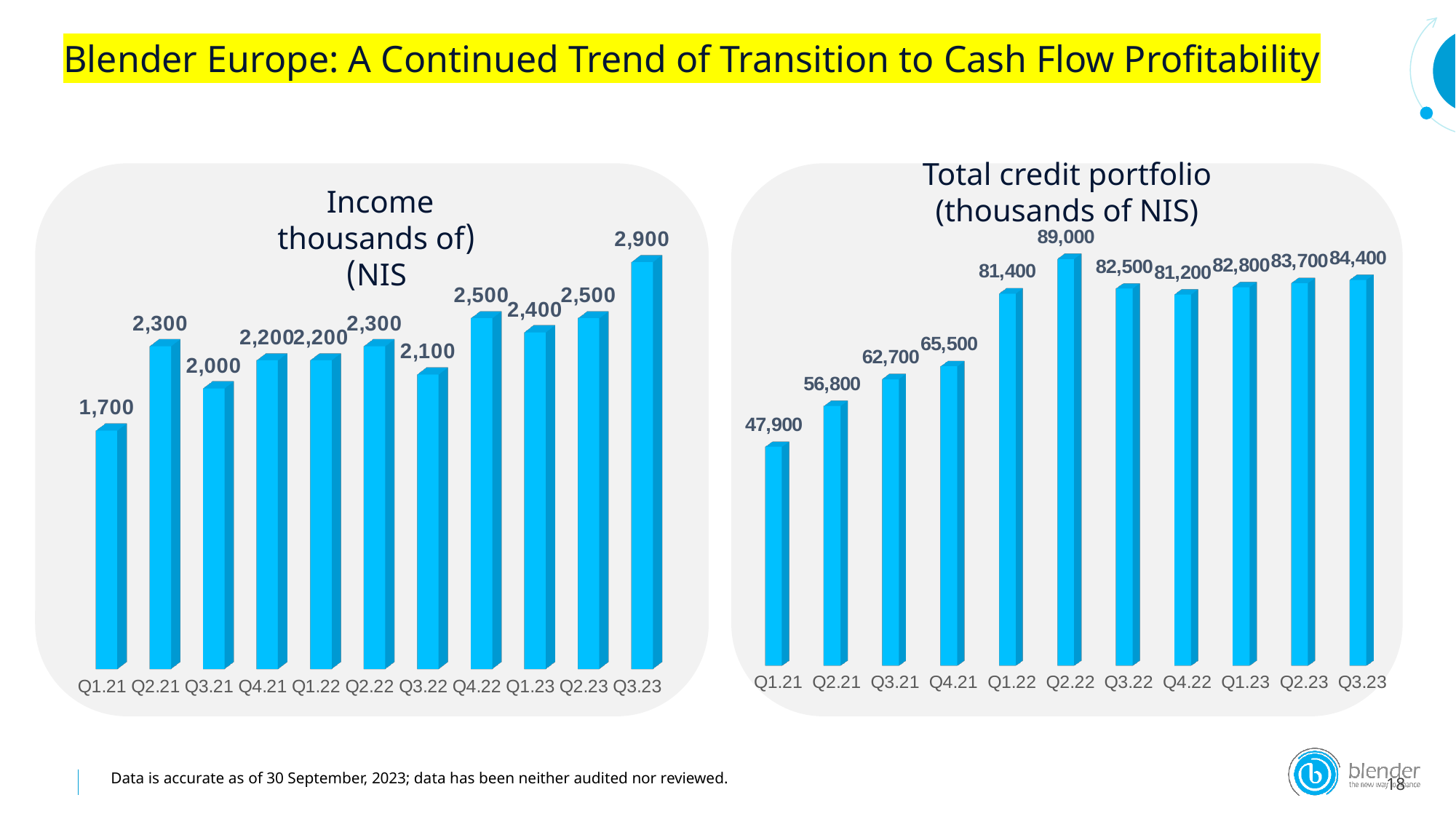
In the Income chart, what is the value for Q3.23? 2,900 In the Total credit portfolio chart, what is the difference between Q3.23 and Q2.23? 700 In the Income chart, which quarter has the highest value? Q3.23 In the Total credit portfolio chart, which is larger, Q1.22 or Q4.22? Q1.22 In the Income chart, what is the value for Q1.21? 1,700 In the Total credit portfolio chart, what is the value for Q1.21? 47,900 In the Income chart, how many quarters are shown? 11 In the Income chart, which quarter has the lowest value? Q1.21 In the Income chart, what is the difference between Q3.23 and Q1.21? 1,200 In the Total credit portfolio chart, what is the value for Q2.22? 89,000 In the Total credit portfolio chart, which quarter has the highest value? Q2.22 What type of chart is the Total credit portfolio chart? Bar chart